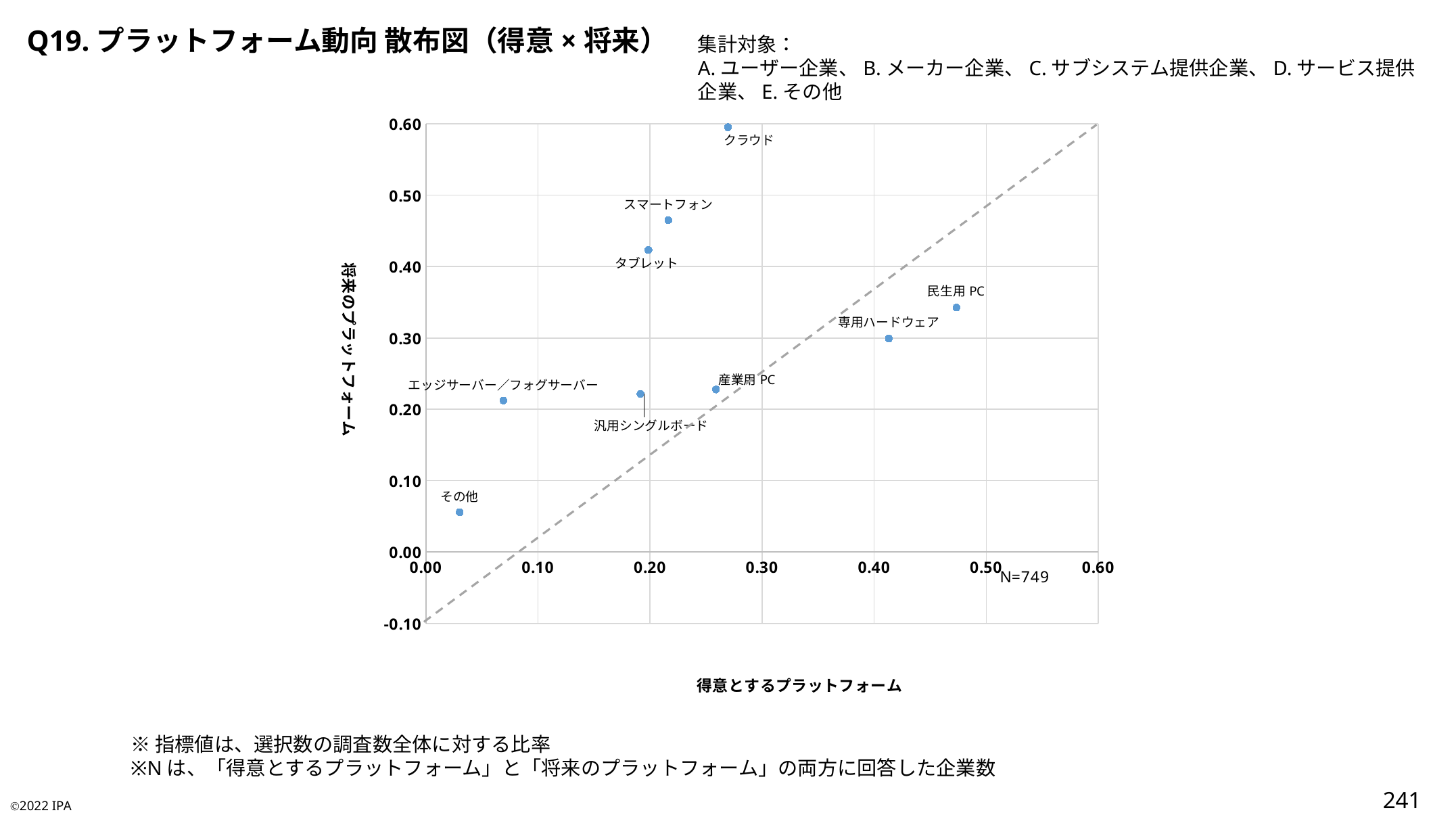
Which platform has the lowest value on the horizontal axis (得意とするプラットフォーム)? その他 Is the vertical-axis (将来のプラットフォーム) value for クラウド greater or less than 0.50? greater Is the horizontal-axis (得意とするプラットフォーム) value for エッジサーバー／フォグサーバー greater or less than 0.10? less Is the horizontal-axis (得意とするプラットフォーム) value for 民生用 PC greater or less than 0.40? greater Which platform has the highest value on the vertical axis (将来のプラットフォーム)? クラウド What kind of chart is shown on the slide? scatter chart How many platform data points are plotted in the scatter chart? 9 Which platform has the lowest value on the vertical axis (将来のプラットフォーム)? その他 Which has the higher vertical-axis (将来のプラットフォーム) value, スマートフォン or タブレット? スマートフォン What is the N value shown on the chart? N=749 Which platform has the highest value on the horizontal axis (得意とするプラットフォーム)? 民生用 PC